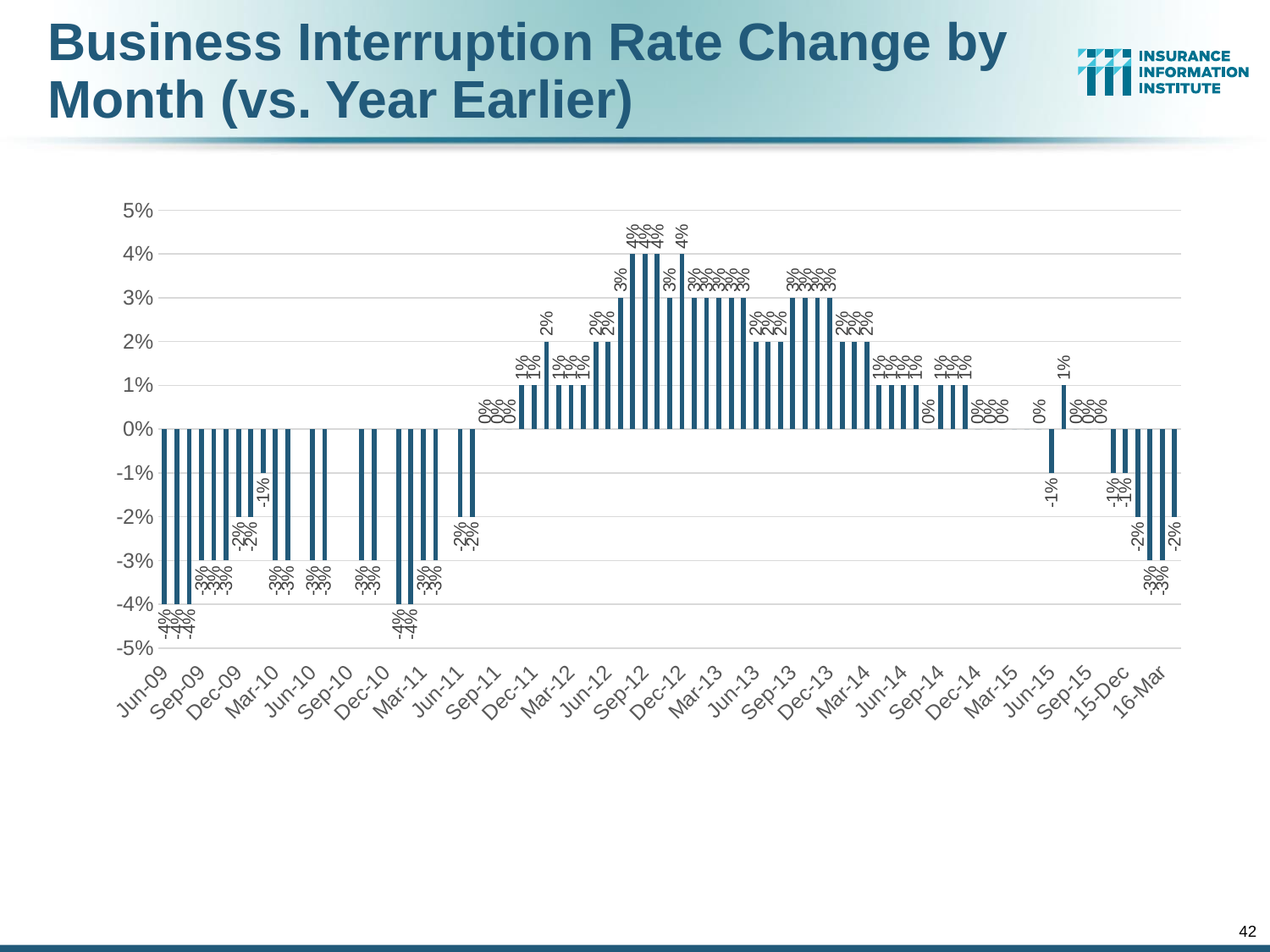
Is the value for Jun-13 greater or less than 1%? greater What is the difference between the rate change for 16-Mar and for Jun-09? 1 percentage point What is the lowest rate change value shown in the chart? -4% Which is larger, the rate change for Jun-09 or for 16-Mar? 16-Mar What kind of chart is shown on the slide? bar chart Is the value for Dec-12 greater or less than 2%? greater Do the rate changes generally rise or fall from Jun-09 to Sep-12? rise What is the rate change for 16-Mar, the last month in the chart? -3% What is the highest rate change value shown in the chart? 4% What is the highest value shown on the vertical axis? 5% What is the rate change for Jun-09, the first month in the chart? -4% What is the title of the chart on the slide? Business Interruption Rate Change by Month (vs. Year Earlier)